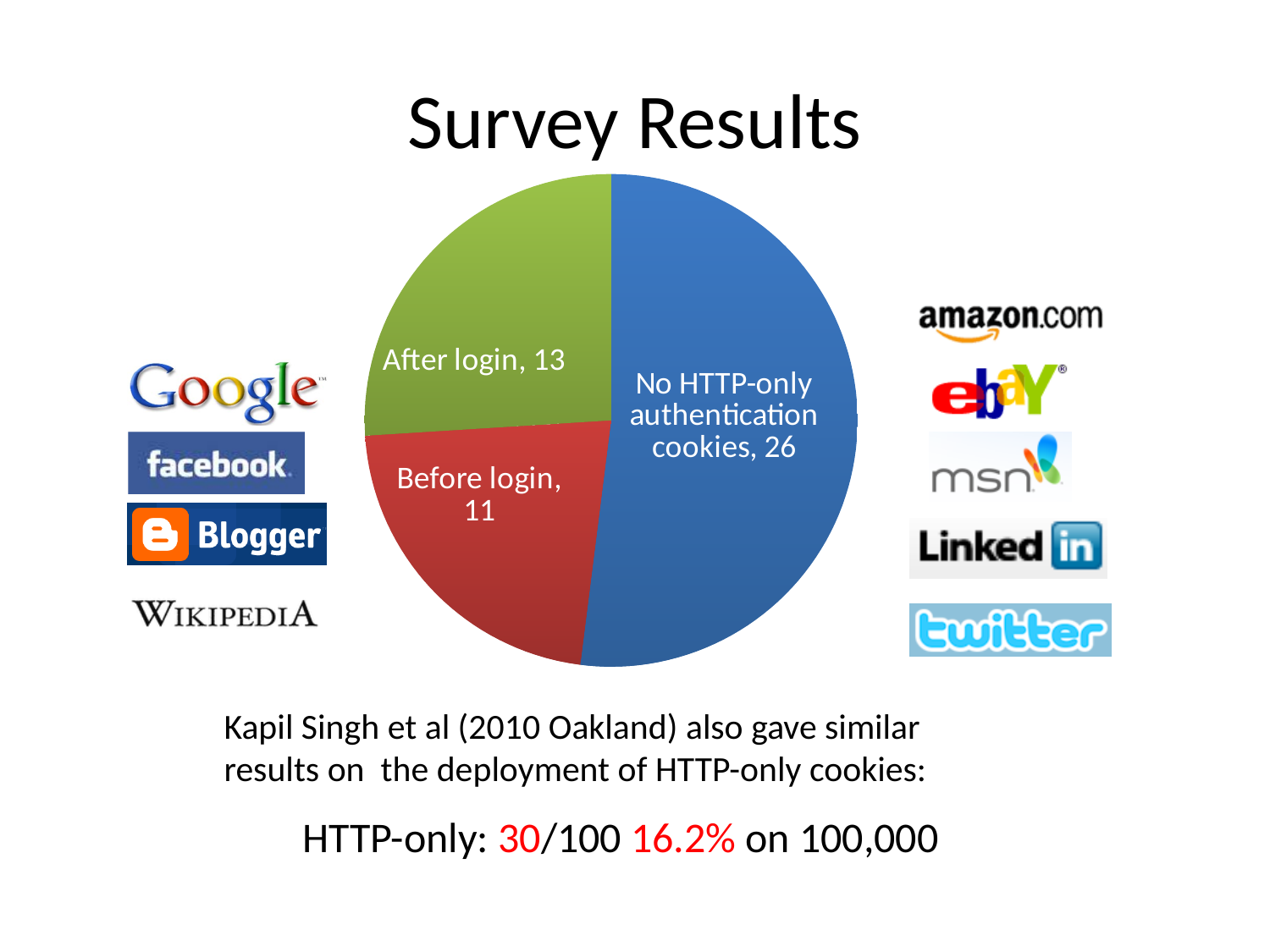
What is the total of all the slices in the pie chart? 50 What share of the pie does the "No HTTP-only authentication cookies" slice represent? 52% What kind of chart is shown on the slide? pie chart Which slice of the pie chart is the smallest? Before login What colour is the "Before login" slice? red Which slice of the pie chart is the largest? No HTTP-only authentication cookies Which is larger, the "After login" value or the "Before login" value? After login What is the difference between the "No HTTP-only authentication cookies" value and the "After login" value? 13 What is the value for the "No HTTP-only authentication cookies" slice? 26 How many slices does the pie chart have? 3 What is the value for the "After login" slice? 13 What is the value for the "Before login" slice? 11